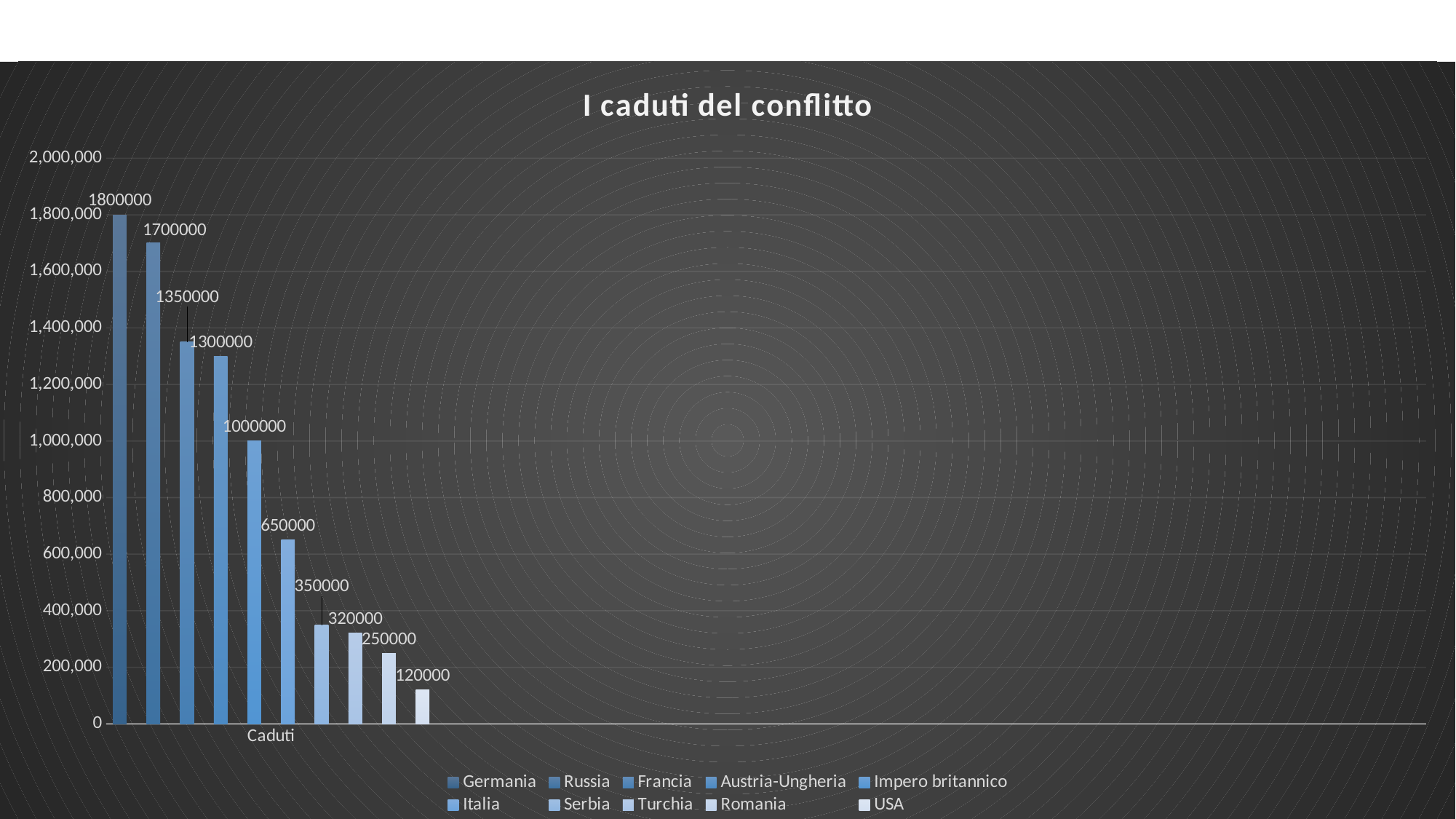
What is the value for USA? 120000 What is the title of the chart? I caduti del conflitto Which series has the highest value? Germania How many series does the legend list? 10 Which is larger, the value for Francia or the value for Austria-Ungheria? Francia What is the value for Italia? 650000 What is the label of the single category on the x axis? Caduti What is the difference between the values for Germania and Russia? 100000 What kind of chart is shown on the slide? bar chart Which series has the lowest value? USA What is the difference between the values for Impero britannico and Italia? 350000 What is the value for Germania? 1800000